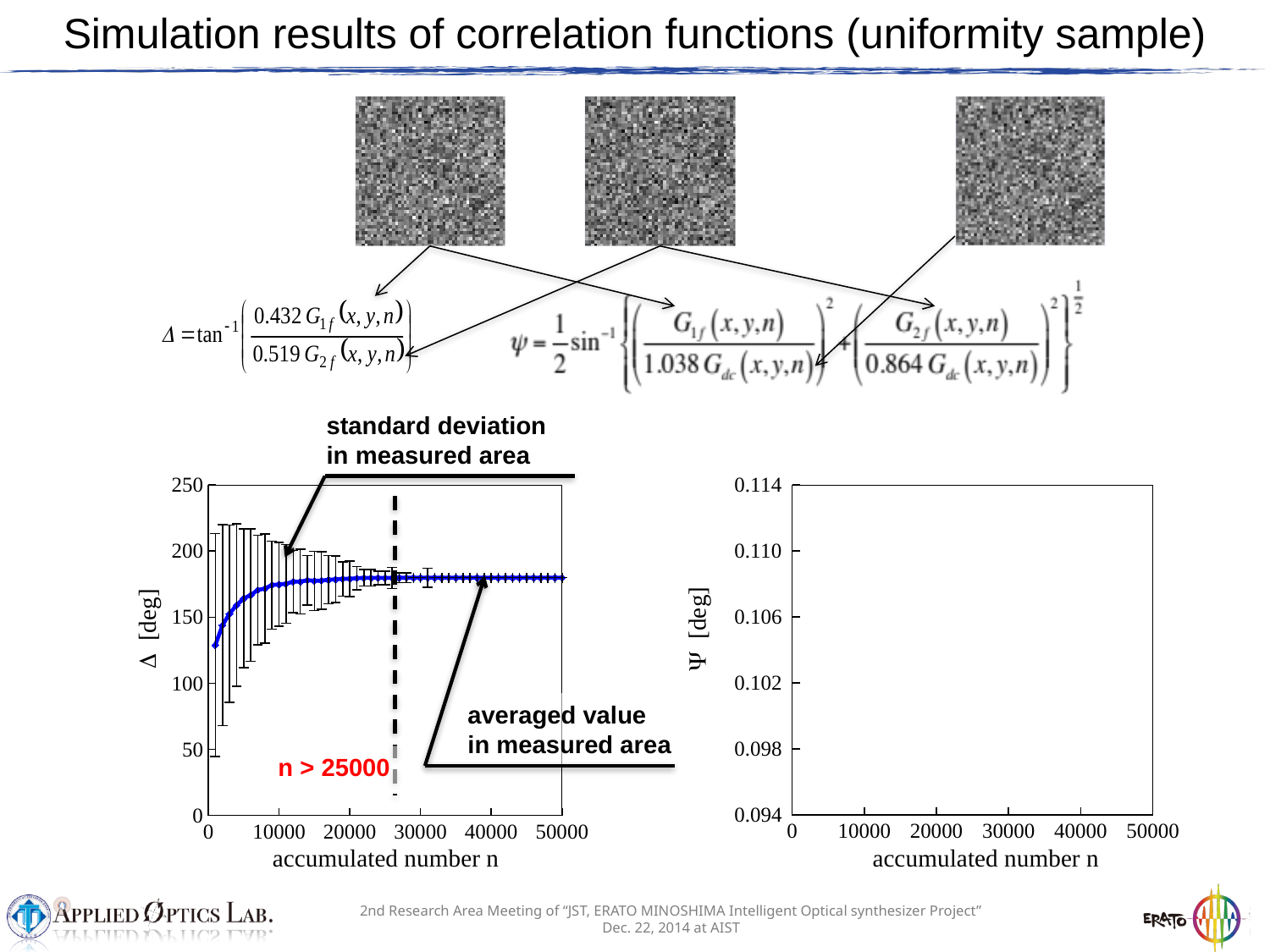
In the left chart, is the value of Δ at n = 20000 greater or less than 200? less What is the y-axis label of the right chart? Ψ [deg] What kind of chart is the left chart (Δ versus accumulated number n)? line chart In the left chart, is the value of Δ at the smallest plotted n (near n = 1000) greater or less than 150? less What is the red annotation text shown in the left chart? n > 25000 In the left chart, is the value of Δ at n = 30000 greater or less than 100? greater In the left chart, does the blue averaged value of Δ rise or fall as the accumulated number n increases? rise In the left chart, do the error bars (standard deviation) get shorter or longer as n increases? shorter In the left chart, which is larger: the value of Δ at n = 50000 or at n = 1000? n = 50000